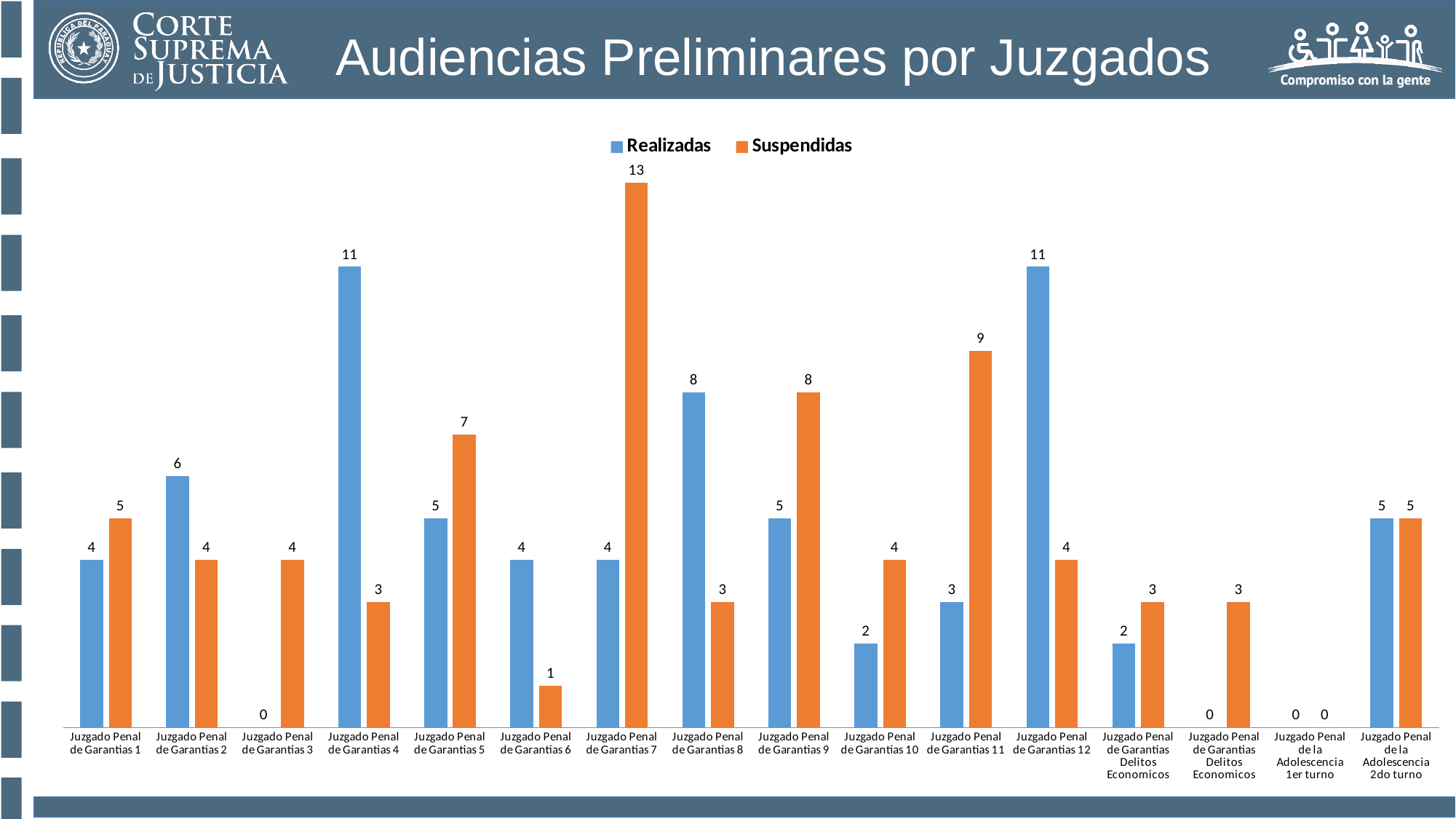
What is the total of Realizadas and Suspendidas for Juzgado Penal de la Adolescencia 2do turno? 10 How many series does the legend list? 2 What is the Realizadas value for Juzgado Penal de Garantias 3? 0 What is the difference between Suspendidas and Realizadas for Juzgado Penal de Garantias 11? 6 What type of chart is shown on the slide? bar chart Which juzgado has the lowest Suspendidas value? Juzgado Penal de la Adolescencia 1er turno What is the Realizadas value for Juzgado Penal de Garantias 4? 11 Which juzgado has the highest Suspendidas value? Juzgado Penal de Garantias 7 For Juzgado Penal de Garantias 8, which is larger, Realizadas or Suspendidas? Realizadas What is the title of the chart on the slide? Audiencias Preliminares por Juzgados How many categories (juzgados) are shown on the x axis? 16 What is the Suspendidas value for Juzgado Penal de Garantias 7? 13